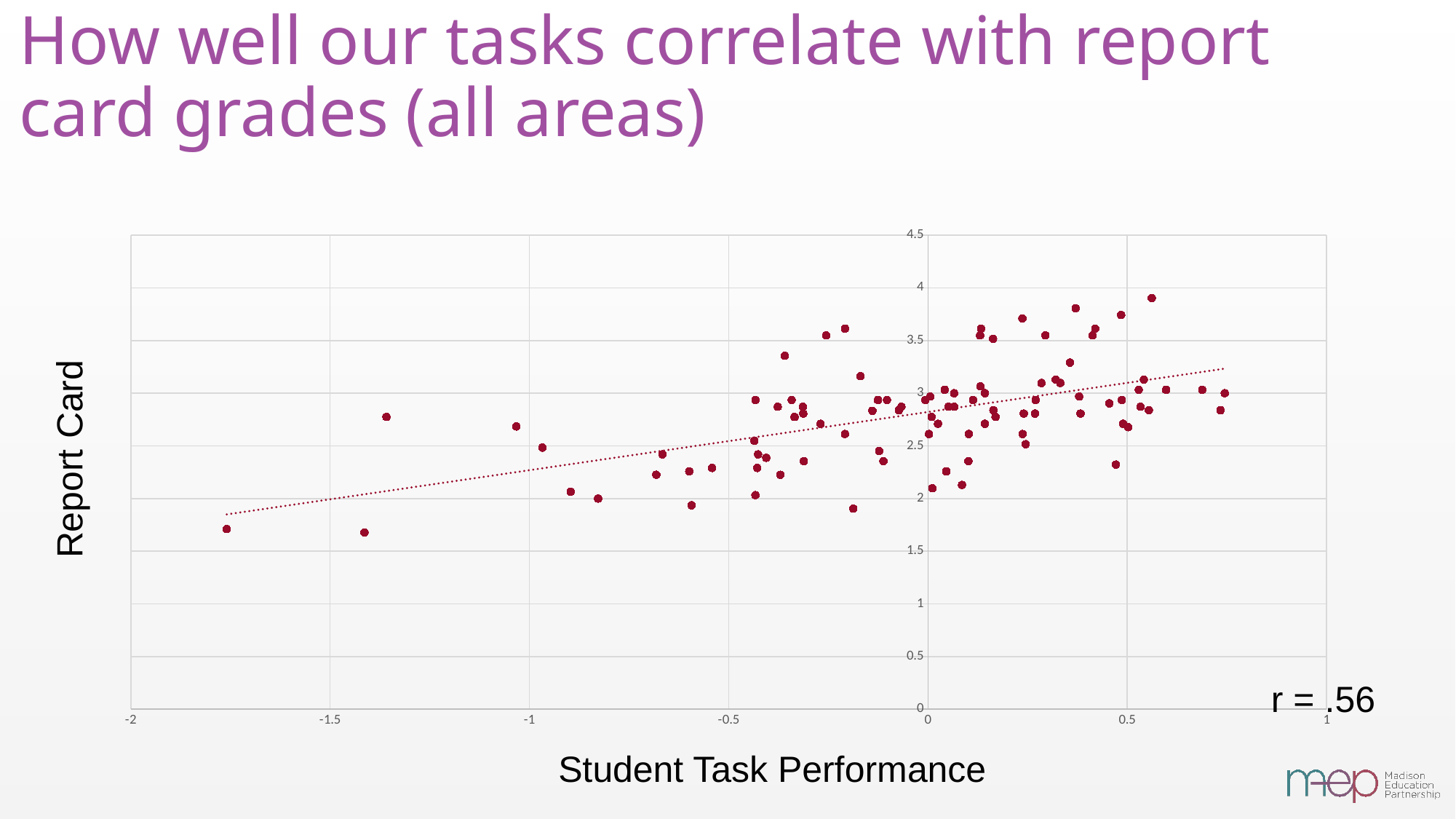
Is the Report Card value of the leftmost point (near -1.75 on the x axis) greater or less than 2? less What correlation coefficient (r) is printed on the slide? r = .56 Is the Report Card value of the highest point on the chart greater or less than 3.5? greater What is the title of the chart on the slide? How well our tasks correlate with report card grades (all areas) What is the lowest tick value shown on the x axis? -2 What kind of chart is shown on the slide? scatter plot What is the label of the x axis? Student Task Performance Does the trend line rise or fall as Student Task Performance increases? rises